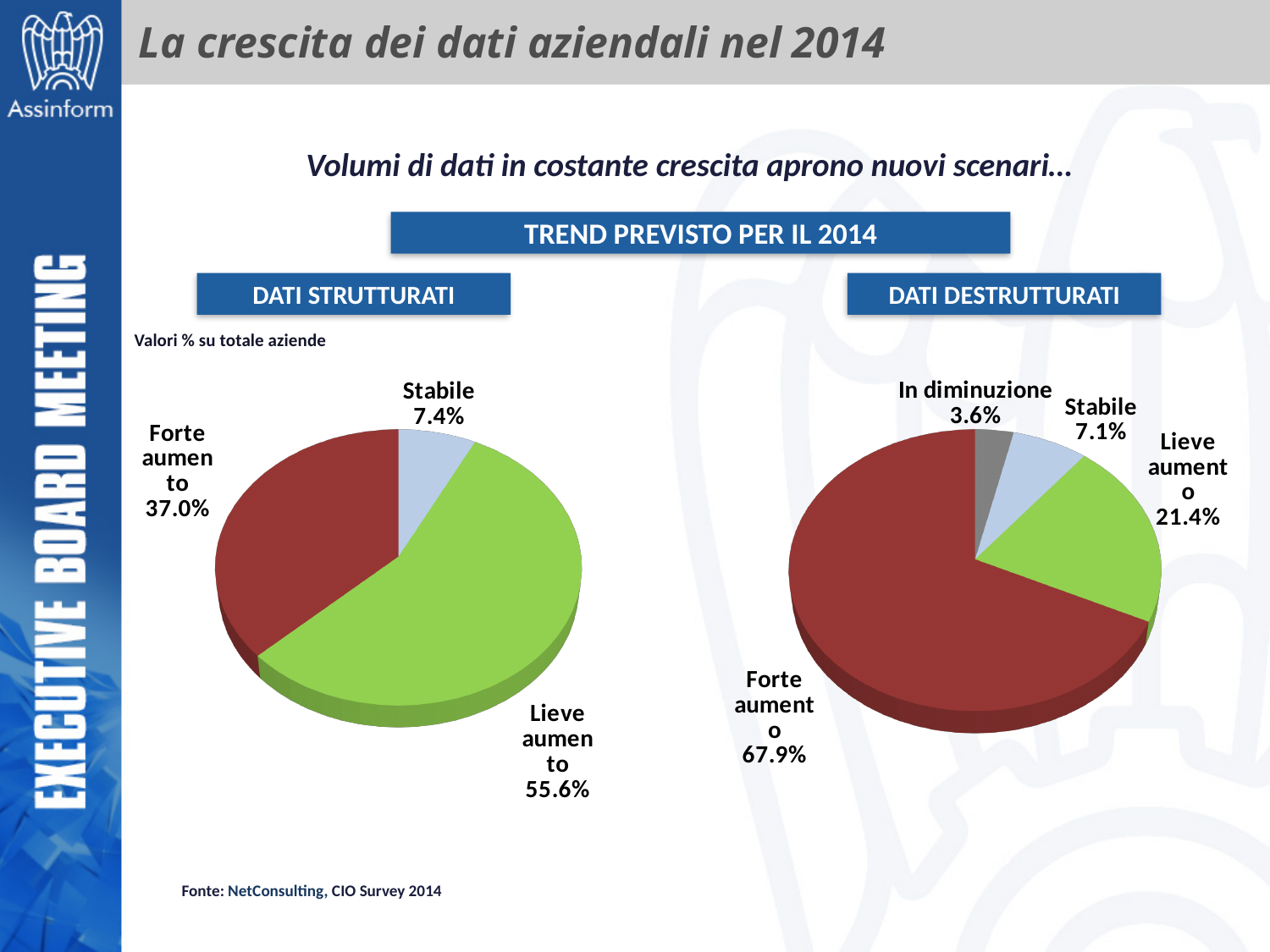
In the DATI DESTRUTTURATI pie chart, what percentage is shown for In diminuzione? 3.6% In the DATI STRUTTURATI pie chart, which category has the smallest share? Stabile In the DATI STRUTTURATI pie chart, which category has the largest share? Lieve aumento In the DATI DESTRUTTURATI pie chart, which category has the smallest share? In diminuzione What type of chart is used for DATI STRUTTURATI? Pie chart In the DATI DESTRUTTURATI pie chart, which category has the largest share? Forte aumento What is the difference between the Forte aumento share in the DATI DESTRUTTURATI chart and the Forte aumento share in the DATI STRUTTURATI chart? 30.9% In the DATI STRUTTURATI pie chart, what percentage is shown for Forte aumento? 37.0% In the DATI DESTRUTTURATI pie chart, what percentage is shown for Lieve aumento? 21.4% Which is larger: Stabile in the DATI STRUTTURATI chart or Stabile in the DATI DESTRUTTURATI chart? DATI STRUTTURATI (7.4%) How many slices does the DATI DESTRUTTURATI pie chart have? 4 In the DATI STRUTTURATI pie chart, what percentage is shown for Lieve aumento? 55.6%